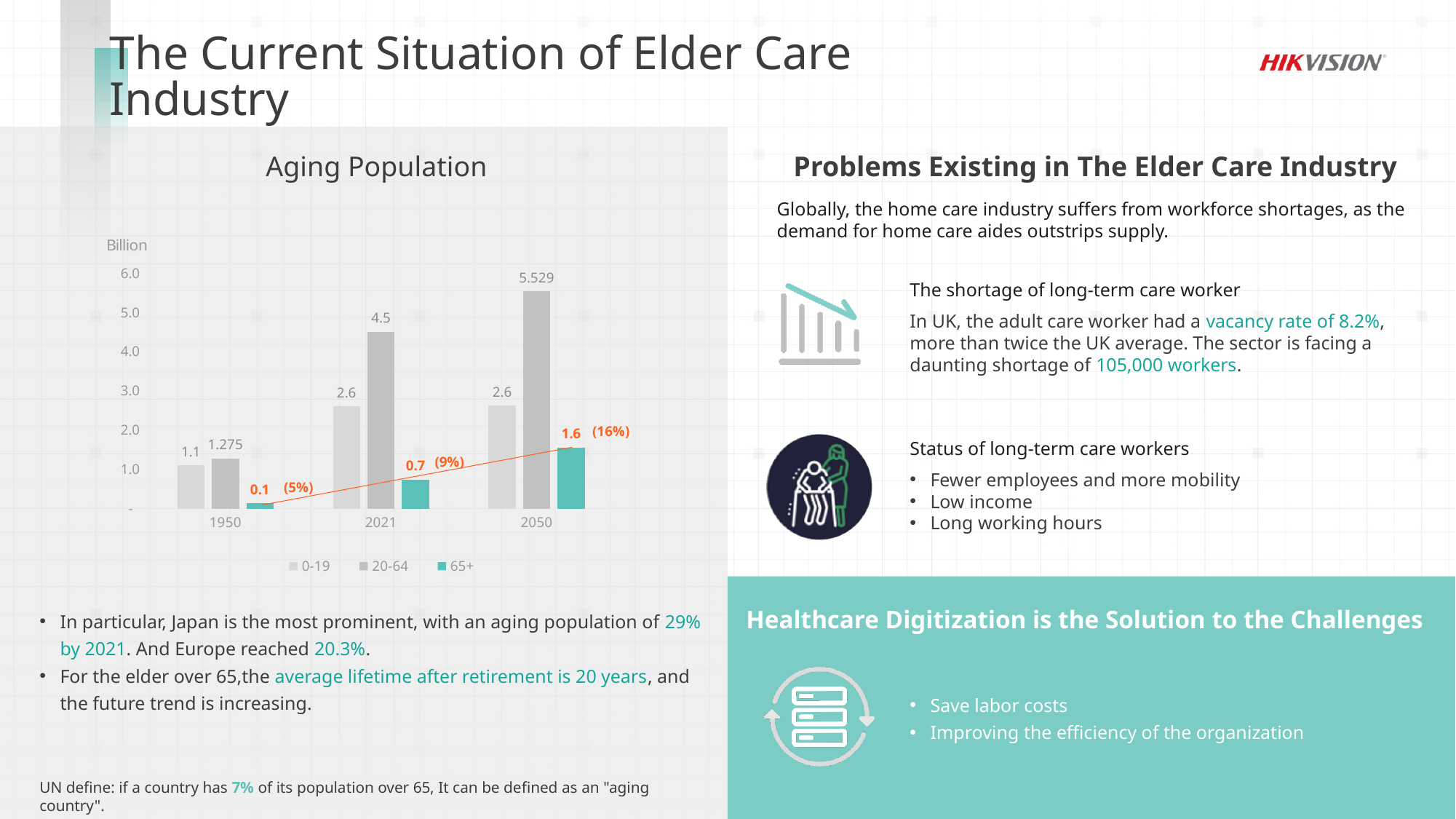
In the Aging Population chart, do the values for the 65+ series rise or fall from 1950 to 2050? rise In the Aging Population chart, which is larger in 2021: the 0-19 value or the 20-64 value? 20-64 How many series does the legend of the Aging Population chart list? 3 What type of chart is the Aging Population chart? bar chart In the Aging Population chart, what is the difference between the 20-64 values for 2050 and 2021? 1.029 In the Aging Population chart, which year has the highest value for the 65+ series? 2050 In the Aging Population chart, what is the value for the 20-64 series in 1950? 1.275 In the Aging Population chart, what is the value for the 0-19 series in 1950? 1.1 How many years are shown on the x axis of the Aging Population chart? 3 In the Aging Population chart, which year has the lowest value for the 20-64 series? 1950 In the Aging Population chart, what is the value for the 20-64 series in 2050? 5.529 In the Aging Population chart, what is the value for the 65+ series in 2021? 0.7